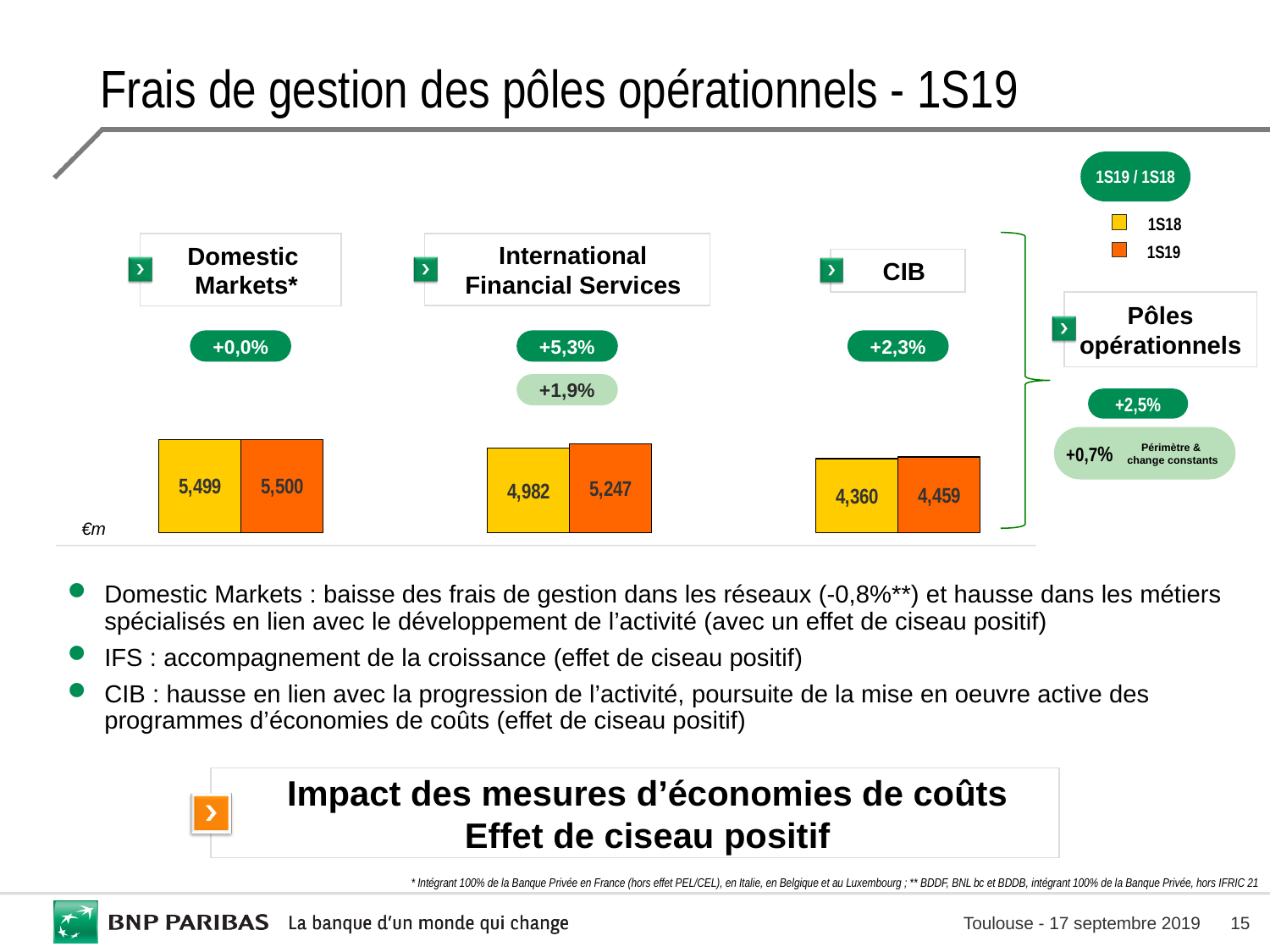
How many series does the legend list? 2 In the Domestic Markets chart, what is the value for 1S19? 5,500 Across the three charts, which business line has the highest 1S18 value? Domestic Markets* In the CIB chart, what is the value for 1S19? 4,459 Which colour represents 1S19 in the legend? orange What kind of chart is used for the Domestic Markets data? bar chart In the CIB chart, what is the value for 1S18? 4,360 In the CIB chart, what is the difference between the 1S19 and 1S18 values? 99 In the International Financial Services chart, which is larger, the 1S18 bar or the 1S19 bar? 1S19 In the International Financial Services chart, what is the difference between the 1S19 and 1S18 values? 265 Across the three charts, which business line has the lowest 1S19 value? CIB In the International Financial Services chart, what is the value for 1S18? 4,982